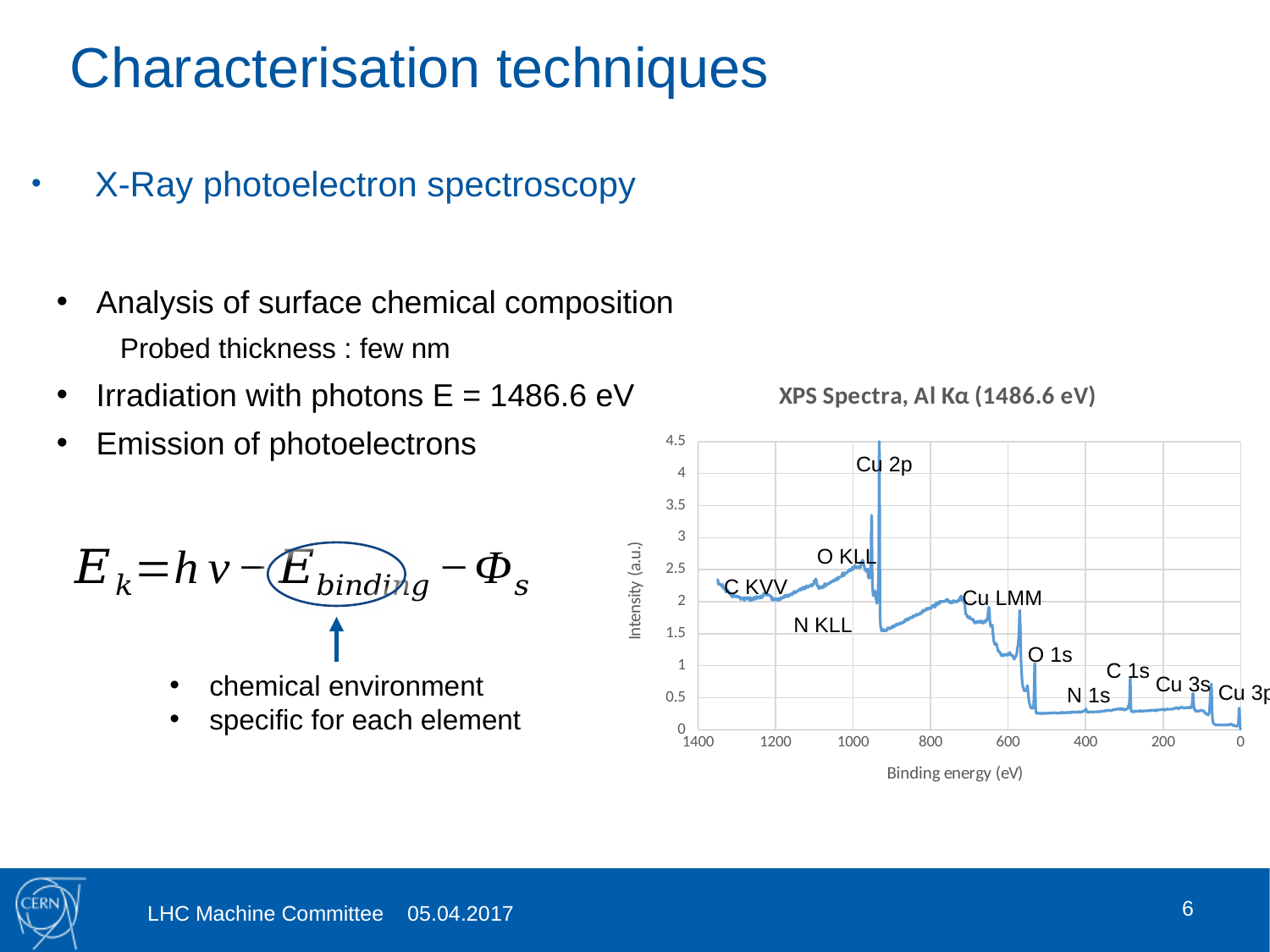
Is the intensity of the Cu 2p peak greater or less than 4? greater Which labelled peak in the XPS spectrum has the highest intensity? Cu 2p What kind of chart is shown on the slide? line chart How many labelled peaks are marked on the XPS spectrum? 10 Which peak has a higher intensity, O KLL or N 1s? O KLL Does the intensity generally rise or fall as the binding energy goes from 1400 eV to 0 eV along the x axis? fall What is the title of the chart? XPS Spectra, Al Kα (1486.6 eV) Is the intensity of the O 1s peak greater or less than 1.5? less What is the label of the x axis of the chart? Binding energy (eV) Is the intensity of the Cu LMM peak greater or less than 2.5? less Which peak has a higher intensity, Cu 2p or O 1s? Cu 2p